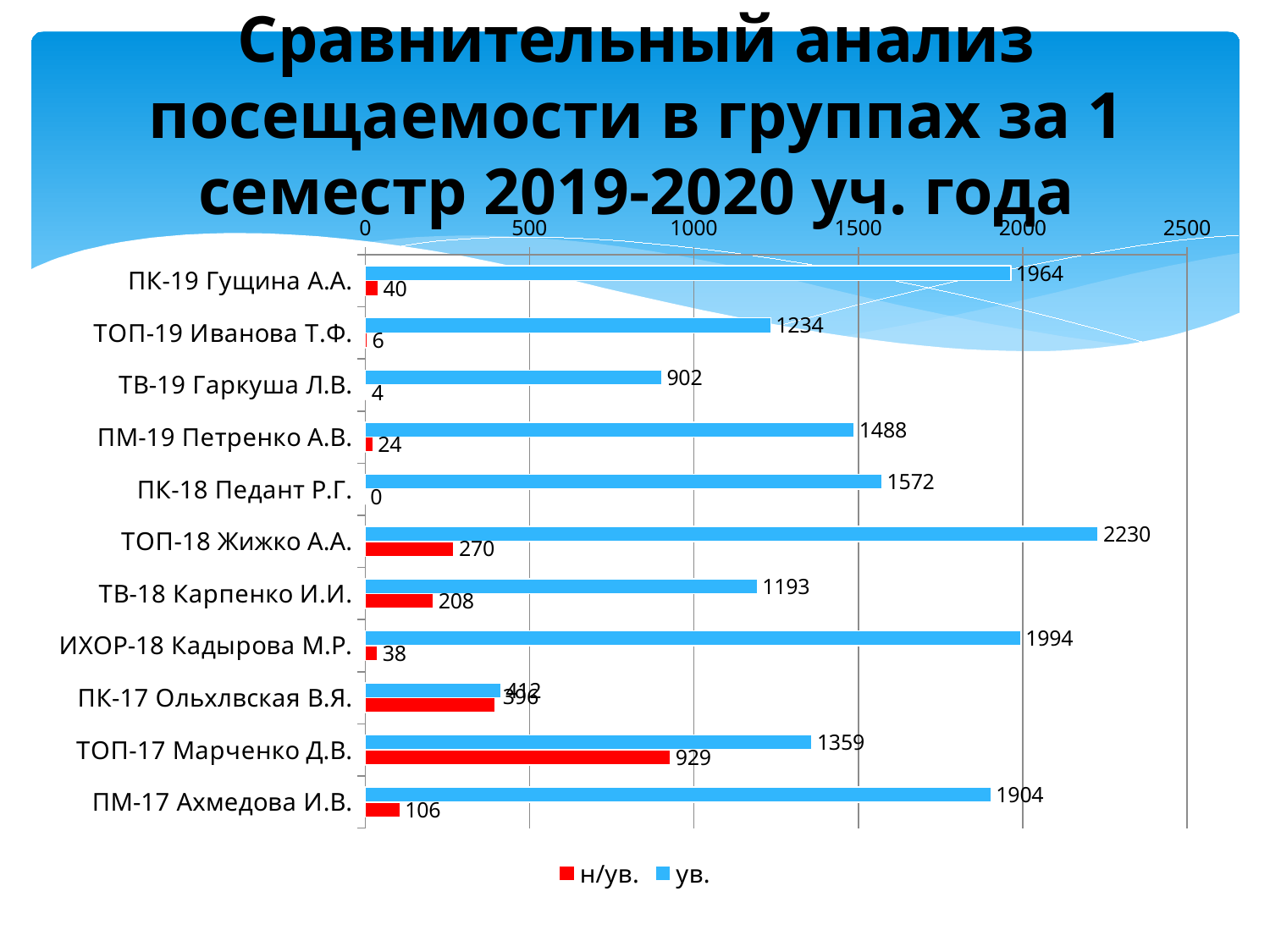
What is the difference between the ув. values of ТОП-18 Жижко А.А. and ИХОР-18 Кадырова М.Р.? 236 What is the ув. value for ТОП-18 Жижко А.А.? 2230 Which group has the highest н/ув. value? ТОП-17 Марченко Д.В. What type of chart is shown on the slide? bar chart What is the н/ув. value for ТОП-17 Марченко Д.В.? 929 What is the ув. value for ТВ-19 Гаркуша Л.В.? 902 Which group has the highest ув. value? ТОП-18 Жижко А.А. How many groups are shown on the chart? 11 How many series does the legend list? 2 Which group has the lowest н/ув. value? ПК-18 Педант Р.Г. Is the ув. value for ПМ-19 Петренко А.В. greater or less than 1500? less Which is larger: the ув. value for ПК-19 Гущина А.А. or for ПМ-17 Ахмедова И.В.? ПК-19 Гущина А.А.